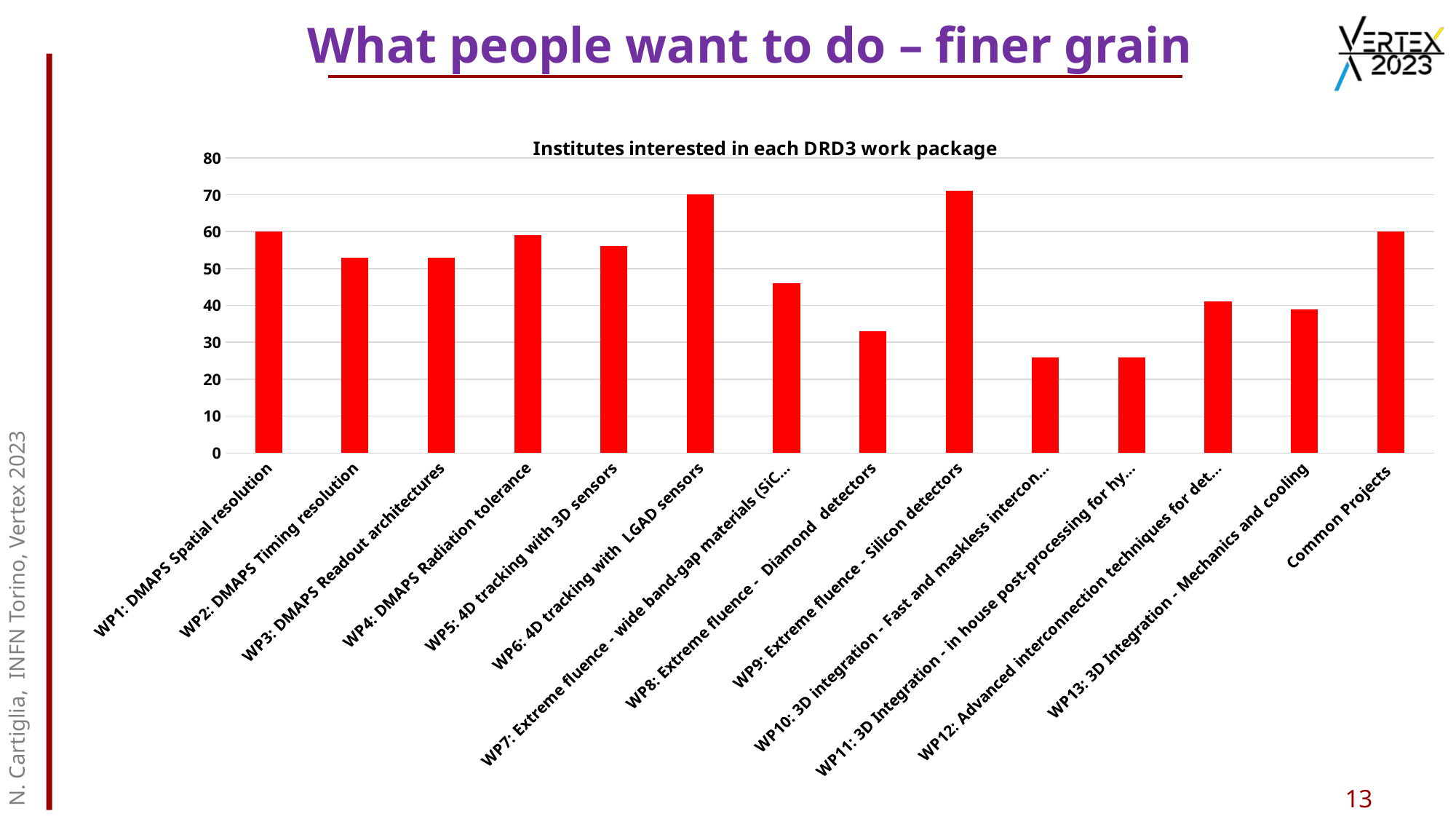
Is the value for WP7: Extreme fluence - wide band-gap materials greater or less than 40? greater What kind of chart is shown on the slide? Bar chart What is the title of the chart? Institutes interested in each DRD3 work package Is the value for WP8: Extreme fluence - Diamond detectors greater or less than 40? less What colour are the bars in the chart? Red Is the value for WP10: 3D integration - Fast and maskless interconnection greater or less than 30? less What is the value for WP6: 4D tracking with LGAD sensors? 70 What is the value for WP1: DMAPS Spatial resolution? 60 How many work package categories are plotted on the x axis? 14 Which has a higher value, WP1: DMAPS Spatial resolution or WP11: 3D Integration - in house post-processing? WP1: DMAPS Spatial resolution Which has a higher value, WP6: 4D tracking with LGAD sensors or WP8: Extreme fluence - Diamond detectors? WP6: 4D tracking with LGAD sensors